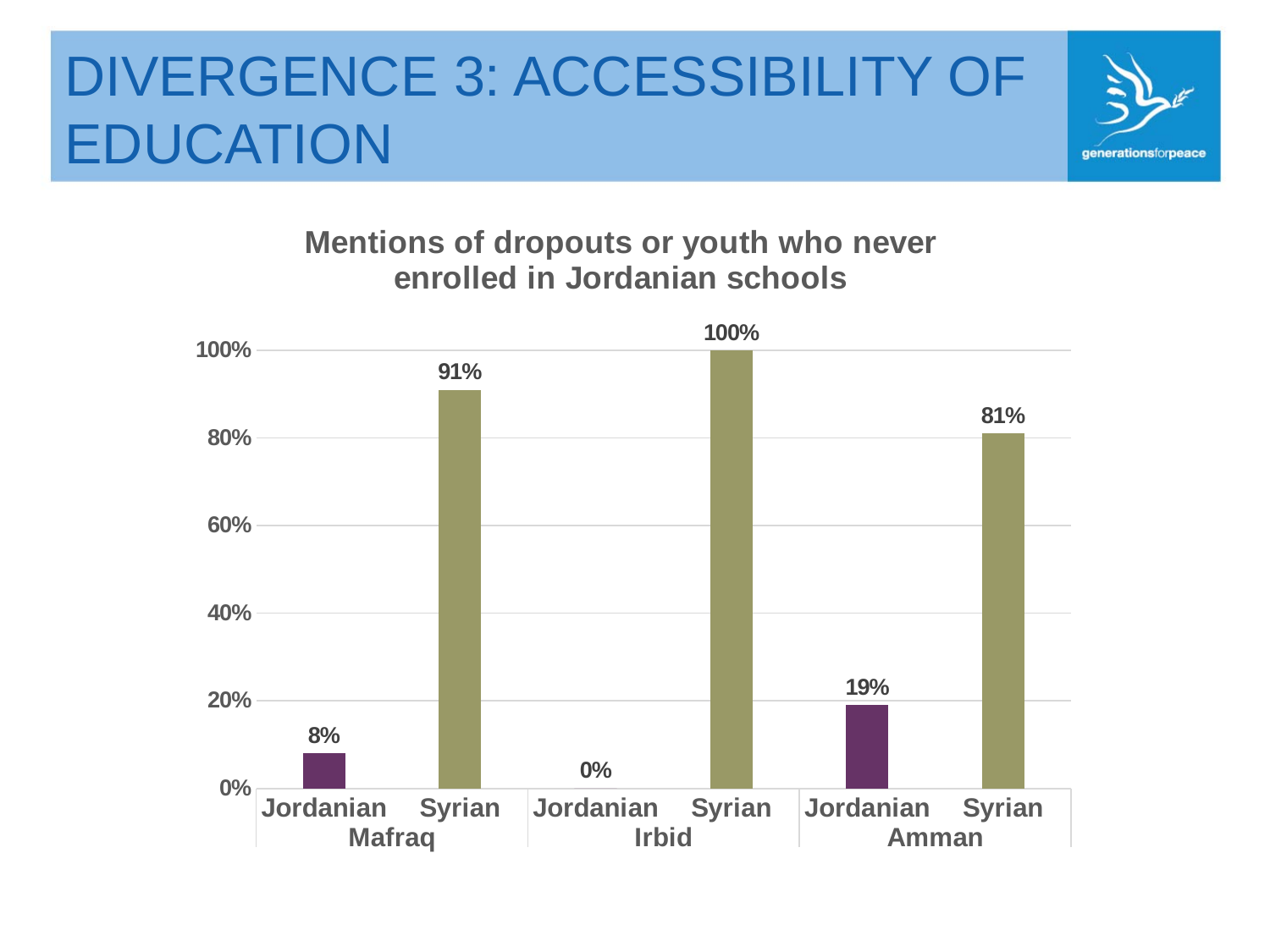
What is the value for Syrian in Mafraq? 91% What is the title of the chart? Mentions of dropouts or youth who never enrolled in Jordanian schools What is the value for Syrian in Amman? 81% What is the value for Jordanian in Irbid? 0% What is the difference between the Syrian and Jordanian values in Mafraq? 83% How many cities are shown on the x axis? 3 Which bar has the highest value? Syrian, Irbid Which bar has the lowest value? Jordanian, Irbid Which is larger: the Syrian value in Amman or the Syrian value in Mafraq? Syrian value in Mafraq What is the value for Jordanian in Amman? 19% How many bars are plotted on the chart? 6 What kind of chart is shown on the slide? Bar chart